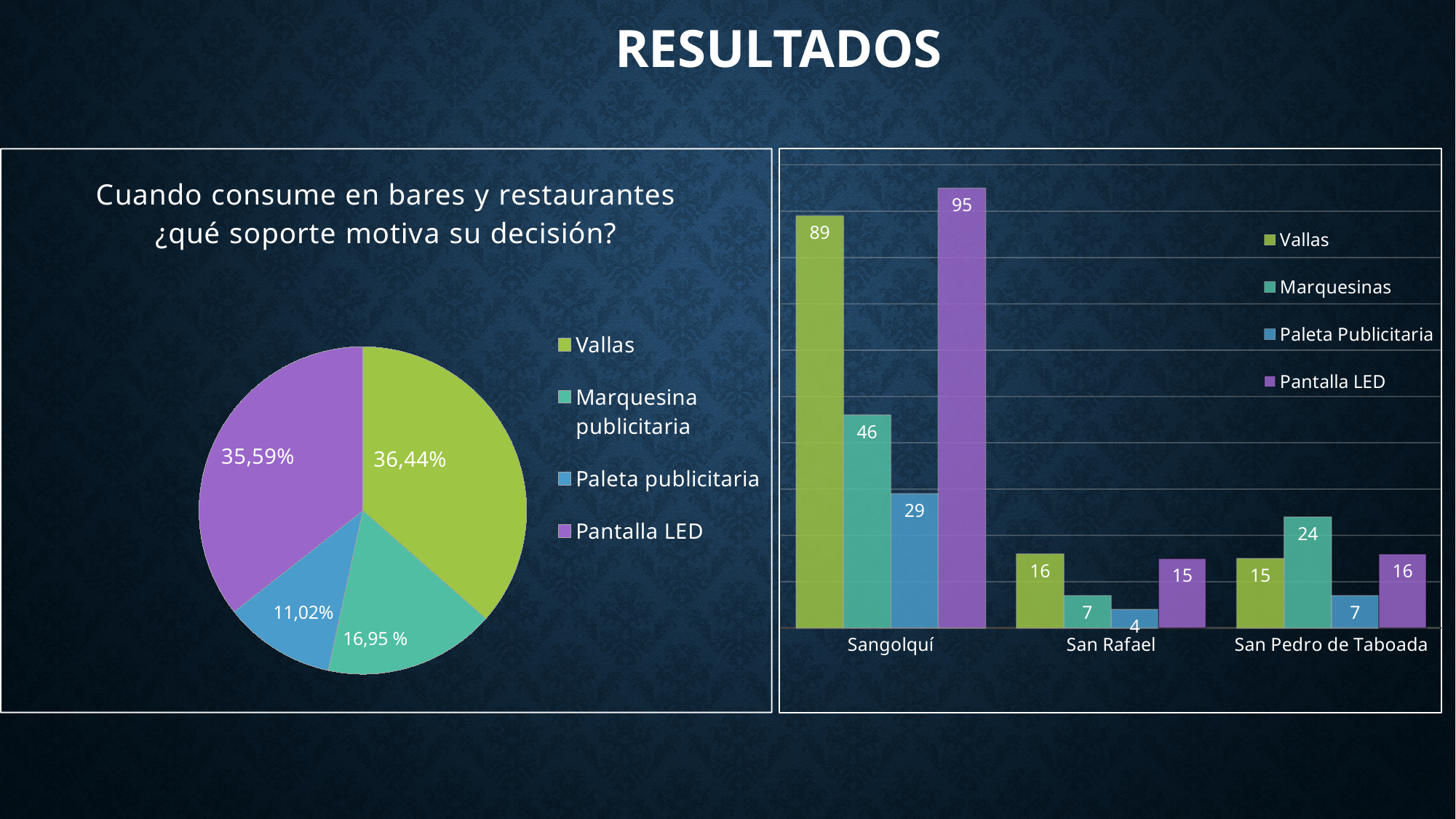
In the bar chart on the right, which is larger: Vallas in San Rafael or Vallas in San Pedro de Taboada? Vallas in San Rafael In the bar chart on the right, how many series does the legend list? 4 In the pie chart on the left, what share does Paleta publicitaria have? 11,02% What type of chart is shown on the right side of the slide? Bar chart In the bar chart on the right, what is the value for Marquesinas in San Pedro de Taboada? 24 In the bar chart on the right, what is the difference between Pantalla LED and Vallas in Sangolquí? 6 In the pie chart on the left, how many categories does the legend list? 4 In the pie chart on the left, which category has the smallest slice? Paleta publicitaria In the bar chart on the right, what is the value for Pantalla LED in Sangolquí? 95 What type of chart is shown on the left side of the slide? Pie chart In the bar chart on the right, which series has the lowest value in San Rafael? Paleta Publicitaria In the pie chart on the left, what share does Vallas have? 36,44%